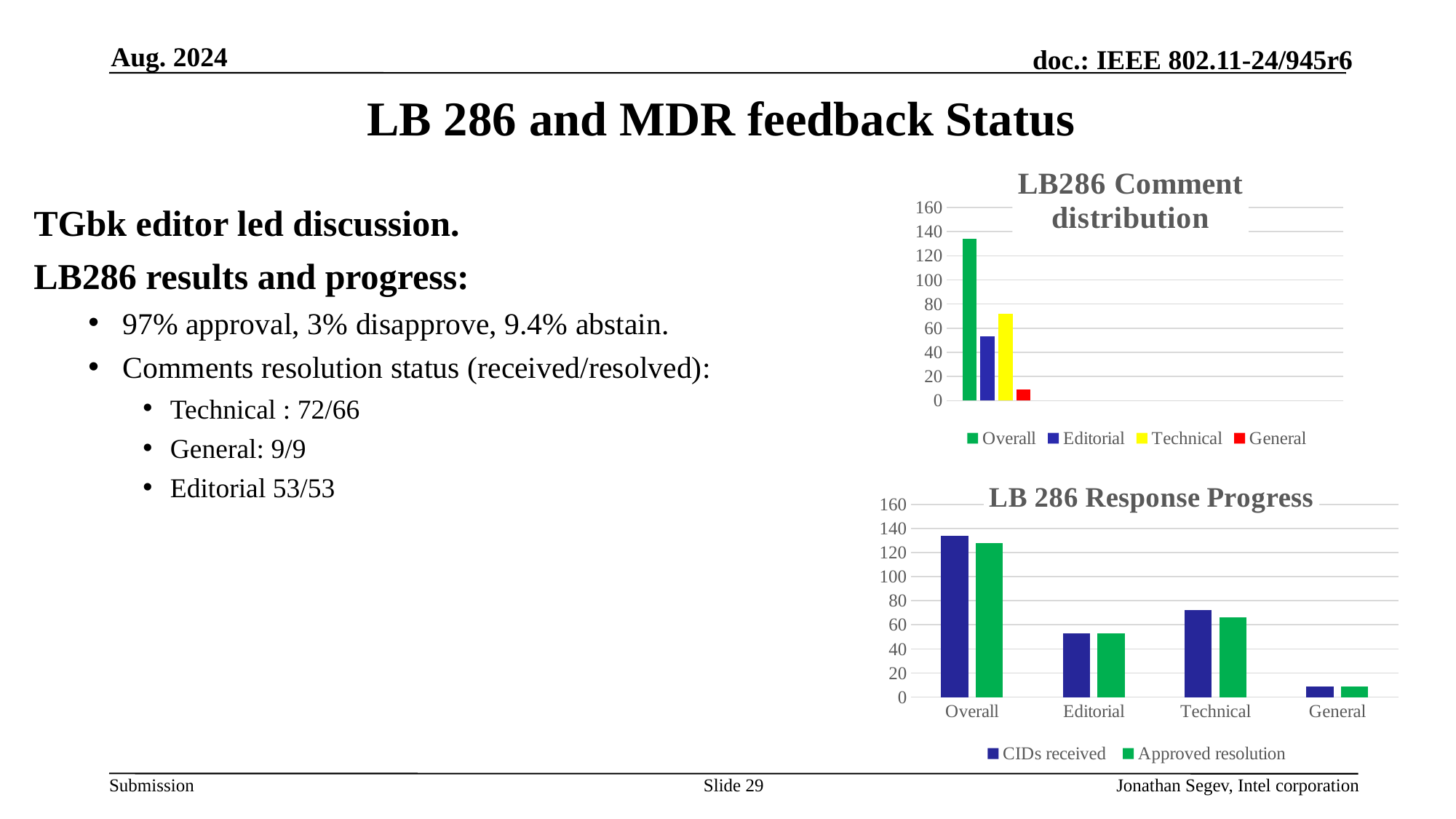
In the 'LB286 Comment distribution' chart, which is larger, Editorial or Technical? Technical How many series does the legend of the 'LB286 Comment distribution' chart list? 4 In the 'LB286 Comment distribution' chart, is the value for Overall greater or less than 120? greater How many categories are shown on the x axis of the 'LB 286 Response Progress' chart? 4 In the 'LB286 Comment distribution' chart, is the value for Technical greater or less than 60? greater How many series does the legend of the 'LB 286 Response Progress' chart list? 2 What type of chart is the 'LB286 Comment distribution' chart? bar chart In the 'LB286 Comment distribution' chart, which series has the highest bar? Overall In the 'LB286 Comment distribution' chart, which series has the lowest bar? General In the 'LB286 Comment distribution' chart, what colour is the Technical bar? yellow In the 'LB 286 Response Progress' chart, which category has the lowest CIDs received? General In the 'LB 286 Response Progress' chart, is the Approved resolution value for Editorial greater or less than 40? greater